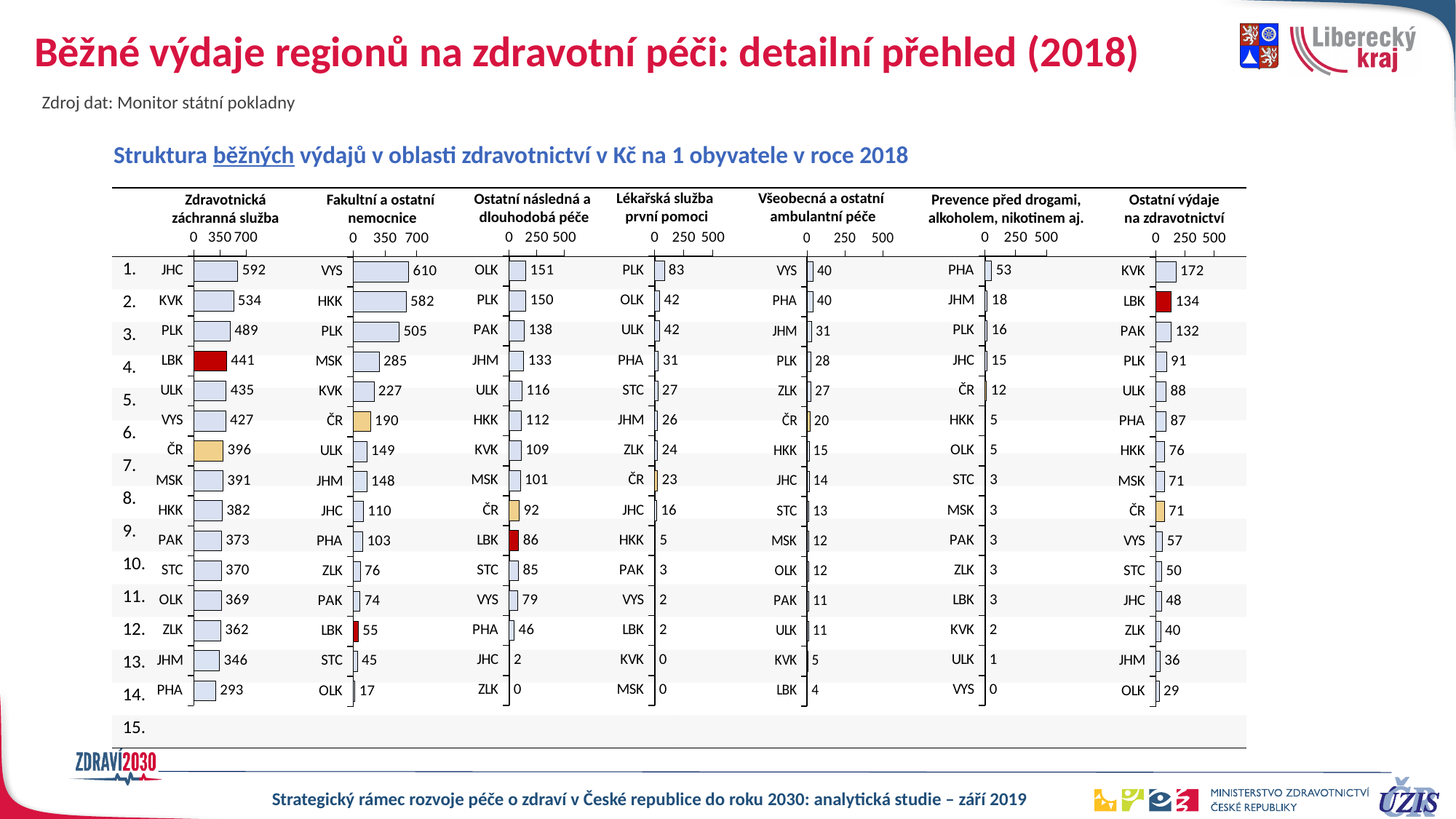
How many regions (bars) are shown in the 'Zdravotnická záchranná služba' chart? 15 In the 'Ostatní následná a dlouhodobá péče' chart, what is the difference between the values for OLK and LBK? 65 In the 'Zdravotnická záchranná služba' chart, is the value for JHC greater or less than 350? greater In the 'Všeobecná a ostatní ambulantní péče' chart, which is larger, the value for JHM or the value for LBK? JHM In the 'Prevence před drogami, alkoholem, nikotinem aj.' chart, what is the value for PHA? 53 In the 'Ostatní výdaje na zdravotnictví' chart, what colour is the bar for LBK? Red In the 'Lékařská služba první pomoci' chart, what is the value for PLK? 83 In the 'Fakultní a ostatní nemocnice' chart, which region has the lowest value? OLK In the 'Fakultní a ostatní nemocnice' chart, which region has the highest value? VYS In the 'Zdravotnická záchranná služba' chart, what is the value for LBK? 441 In the 'Ostatní výdaje na zdravotnictví' chart, what is the difference between the values for KVK and LBK? 38 What kind of chart is used for 'Fakultní a ostatní nemocnice'? Bar chart